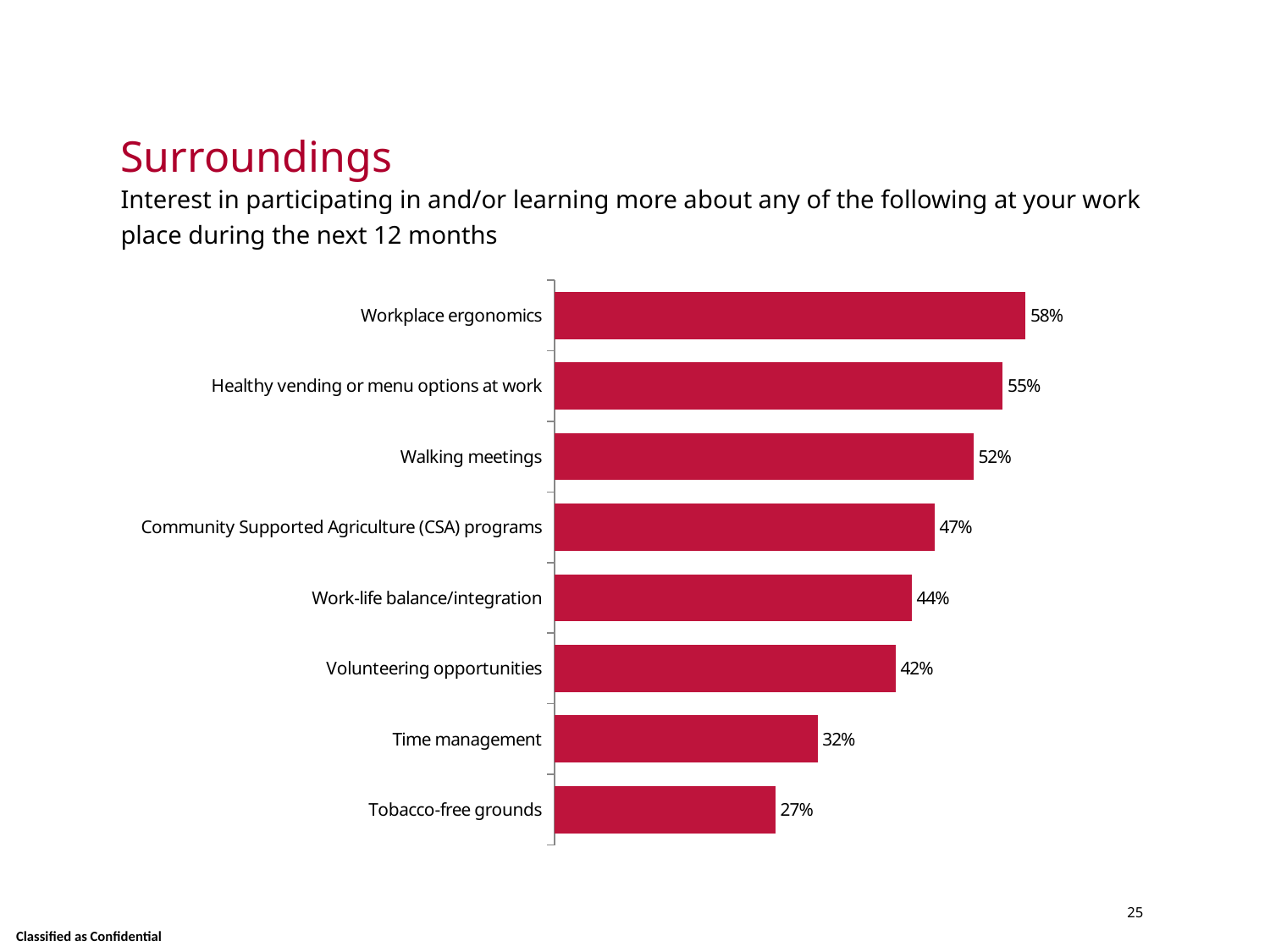
What is the difference between the values for Workplace ergonomics and Tobacco-free grounds? 31% What is the value shown for Walking meetings? 52% Do the values increase or decrease going from the top bar to the bottom bar? Decrease What is the title of the slide containing the chart? Surroundings What kind of chart is shown on the slide? Bar chart How many categories are shown in the chart? 8 What is the difference between the values for Healthy vending or menu options at work and Time management? 23% What percentage of respondents expressed interest in workplace ergonomics? 58% Which category has the highest value? Workplace ergonomics Which category has the lowest value? Tobacco-free grounds Which is larger, the value for Work-life balance/integration or the value for Volunteering opportunities? Work-life balance/integration What is the value shown for Tobacco-free grounds? 27%